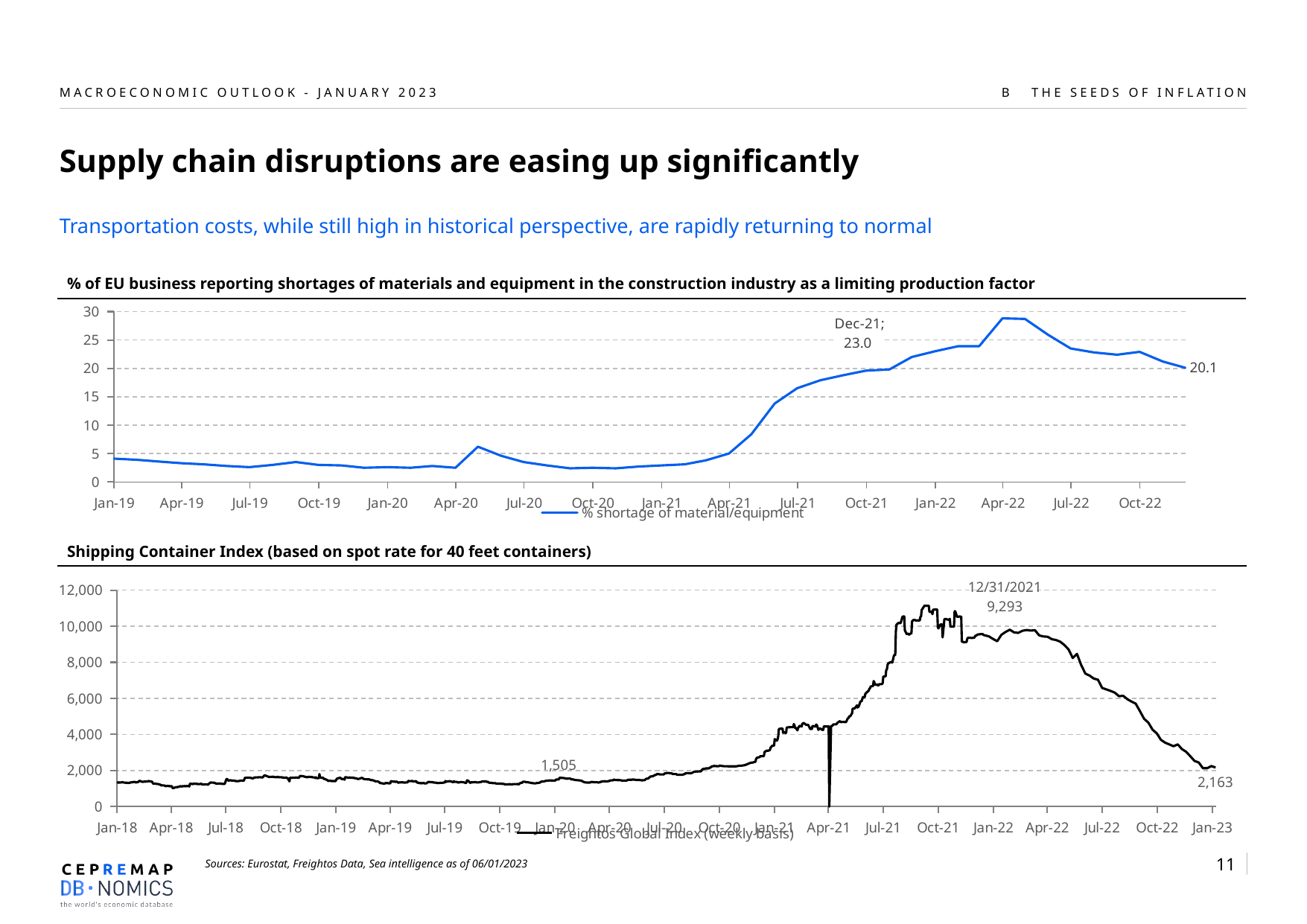
In the top chart (% of EU business reporting shortages of materials and equipment), what is the value labelled at the end of the series? 20.1 In the bottom chart (Shipping Container Index), what is the difference between the 12/31/2021 value and the final labelled value? 7,130 In the bottom chart (Shipping Container Index), which is larger: the value labelled 1,505 or the value labelled 2,163? 2,163 In the bottom chart (Shipping Container Index), does the series rise or fall between Oct-21 and Jan-23? fall In the bottom chart (Shipping Container Index), what value is labelled for 12/31/2021? 9,293 In the bottom chart (Shipping Container Index), what is the value labelled at the end of the series near Jan-23? 2,163 In the top chart (% of EU business reporting shortages of materials and equipment), is the peak value around Apr-22 greater or less than 25? greater In the top chart (% of EU business reporting shortages of materials and equipment), what is the difference between the Dec-21 value and the final labelled value? 2.9 In the top chart (% of EU business reporting shortages of materials and equipment), what is the legend entry for the series? % shortage of material/equipment In the top chart (% of EU business reporting shortages of materials and equipment), is the value at Jan-19 greater or less than 5? less In the top chart (% of EU business reporting shortages of materials and equipment), what kind of chart is shown? line chart In the top chart (% of EU business reporting shortages of materials and equipment), what value is labelled for Dec-21? 23.0